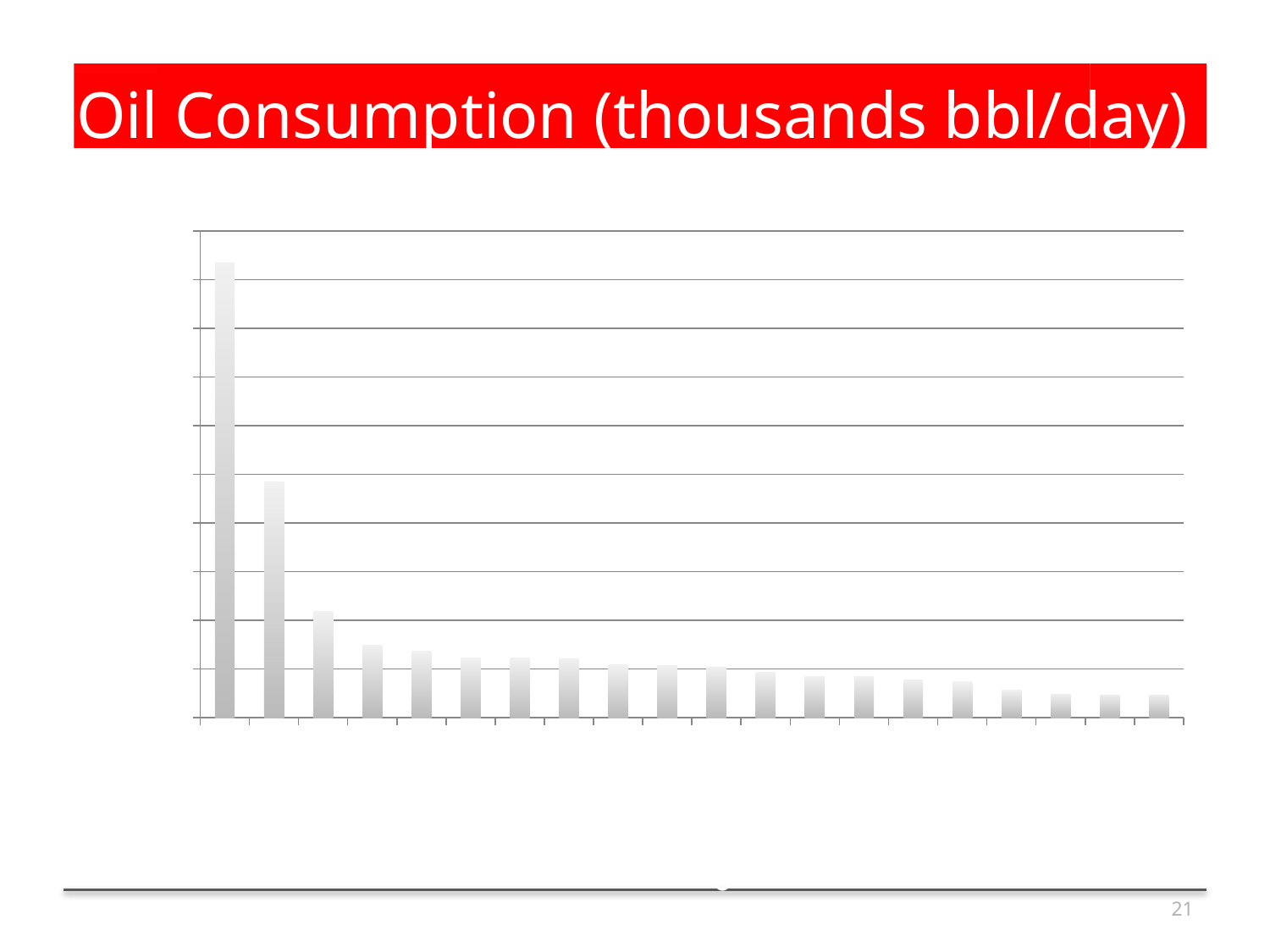
Which bar is the tallest in the chart? the leftmost (first) bar In what unit does the chart title say oil consumption is measured? thousands bbl/day What is the title of the chart on the slide? Oil Consumption (thousands bbl/day) How many bars are plotted in the chart? 20 Which is larger, the first bar or the second bar from the left? the first bar Which is larger, the second bar or the third bar from the left? the second bar What kind of chart is shown on the slide? bar chart Do the bar values rise or fall from left to right across the chart? fall